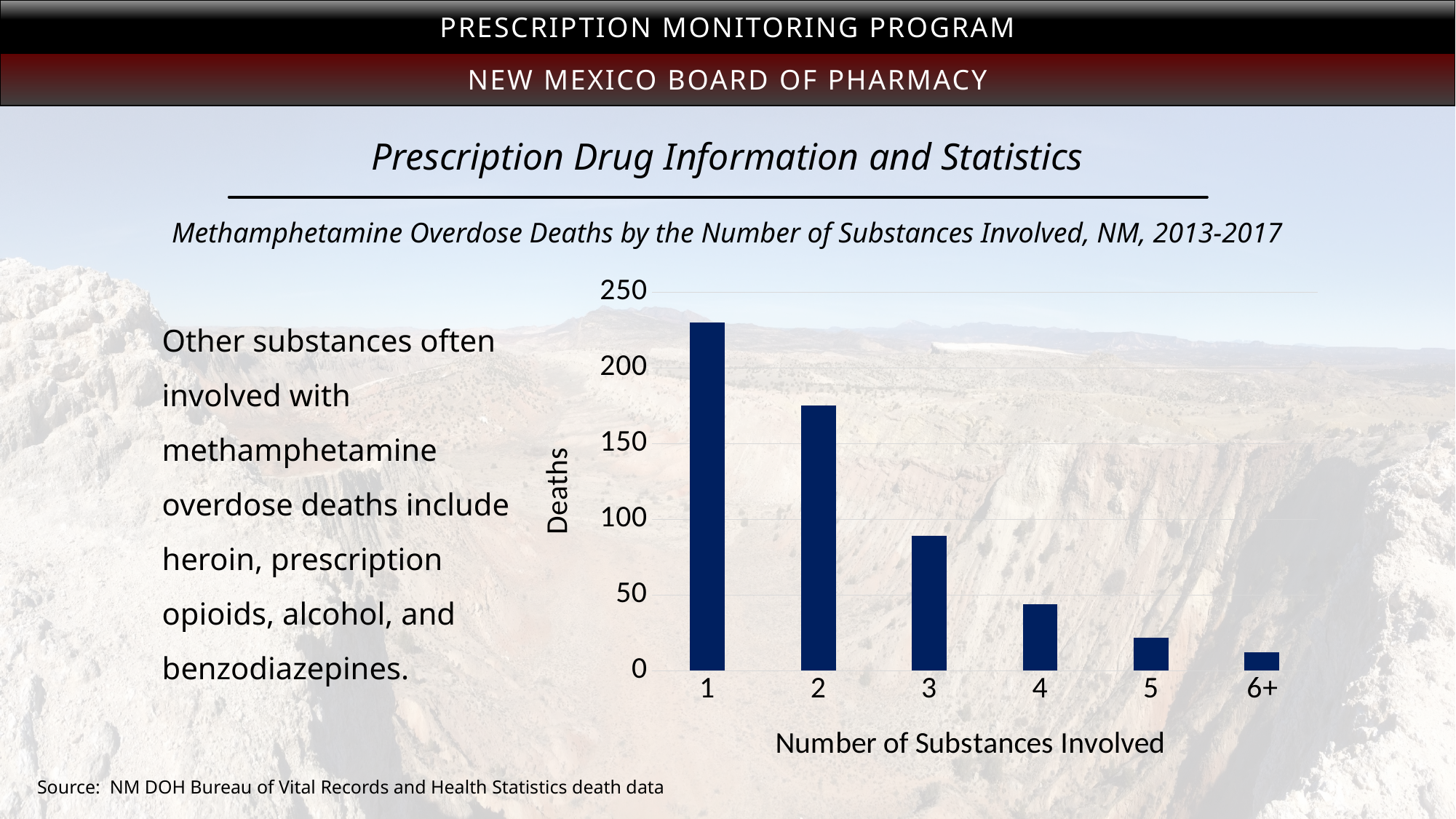
Do the number of deaths rise or fall as the number of substances involved increases? fall Is the number of deaths for 3 substances involved greater or less than 100? less Is the number of deaths for 1 substance involved greater or less than 200? greater Which number of substances involved has the highest number of deaths? 1 Which has more deaths: 2 substances involved or 3 substances involved? 2 Is the number of deaths for 2 substances involved greater or less than 200? less What is the label of the y axis of the chart? Deaths What kind of chart is shown on the slide? bar chart How many categories are shown on the x axis of the chart? 6 Which number of substances involved has the lowest number of deaths? 6+